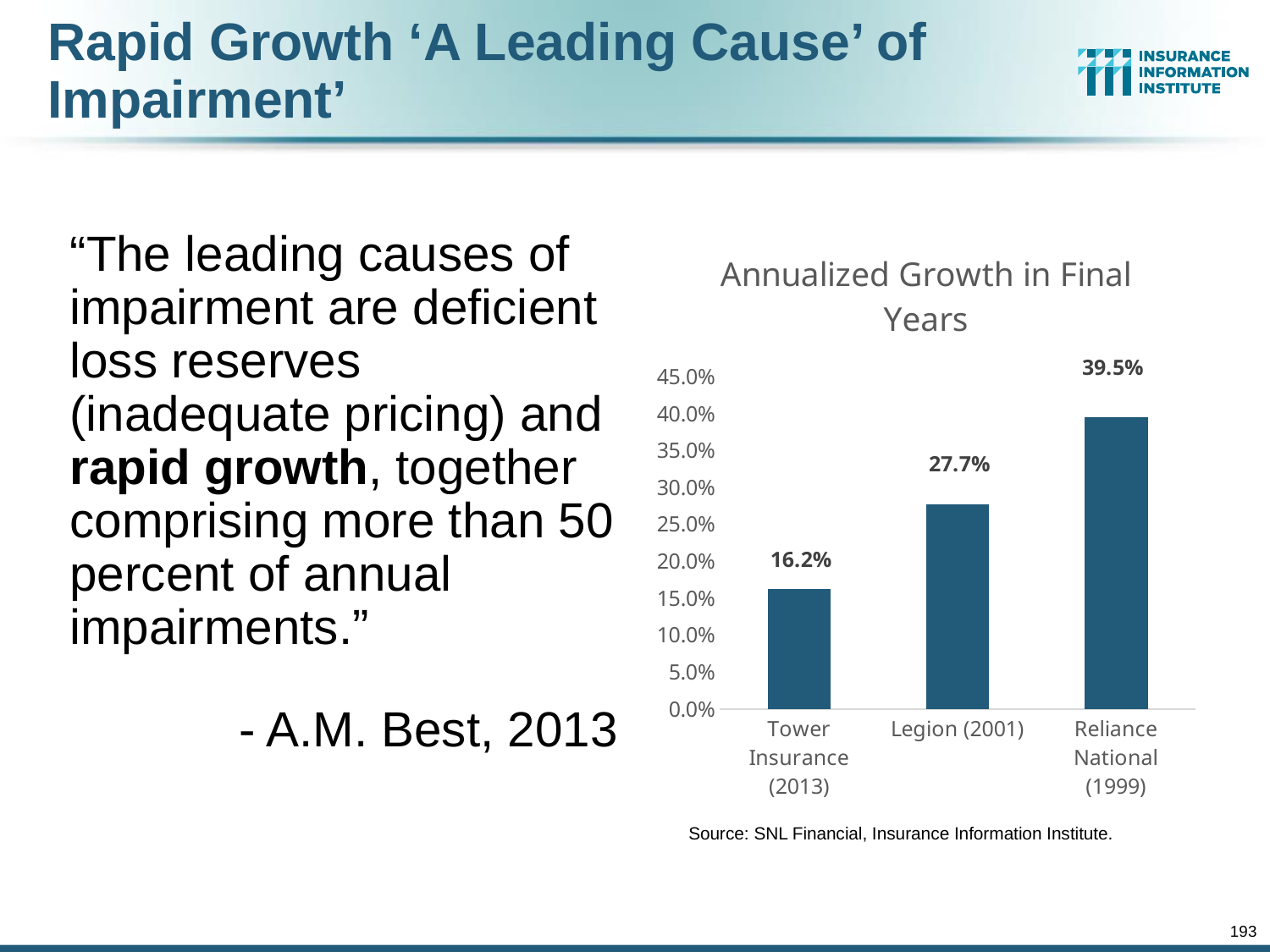
What is the annualized growth in final years for Legion (2001)? 27.7% What is the annualized growth in final years for Tower Insurance (2013)? 16.2% Which has a higher annualized growth in final years, Legion (2001) or Tower Insurance (2013)? Legion (2001) What type of chart is used to show annualized growth in final years? Bar chart How many companies are shown in the chart? 3 Is the annualized growth for Legion (2001) greater or less than 25.0%? greater What is the annualized growth in final years for Reliance National (1999)? 39.5% Which company has the lowest annualized growth in final years? Tower Insurance (2013) What is the difference in annualized growth between Reliance National (1999) and Tower Insurance (2013)? 23.3% Which company has the highest annualized growth in final years? Reliance National (1999) What is the title of the chart? Annualized Growth in Final Years What is the difference in annualized growth between Legion (2001) and Tower Insurance (2013)? 11.5%